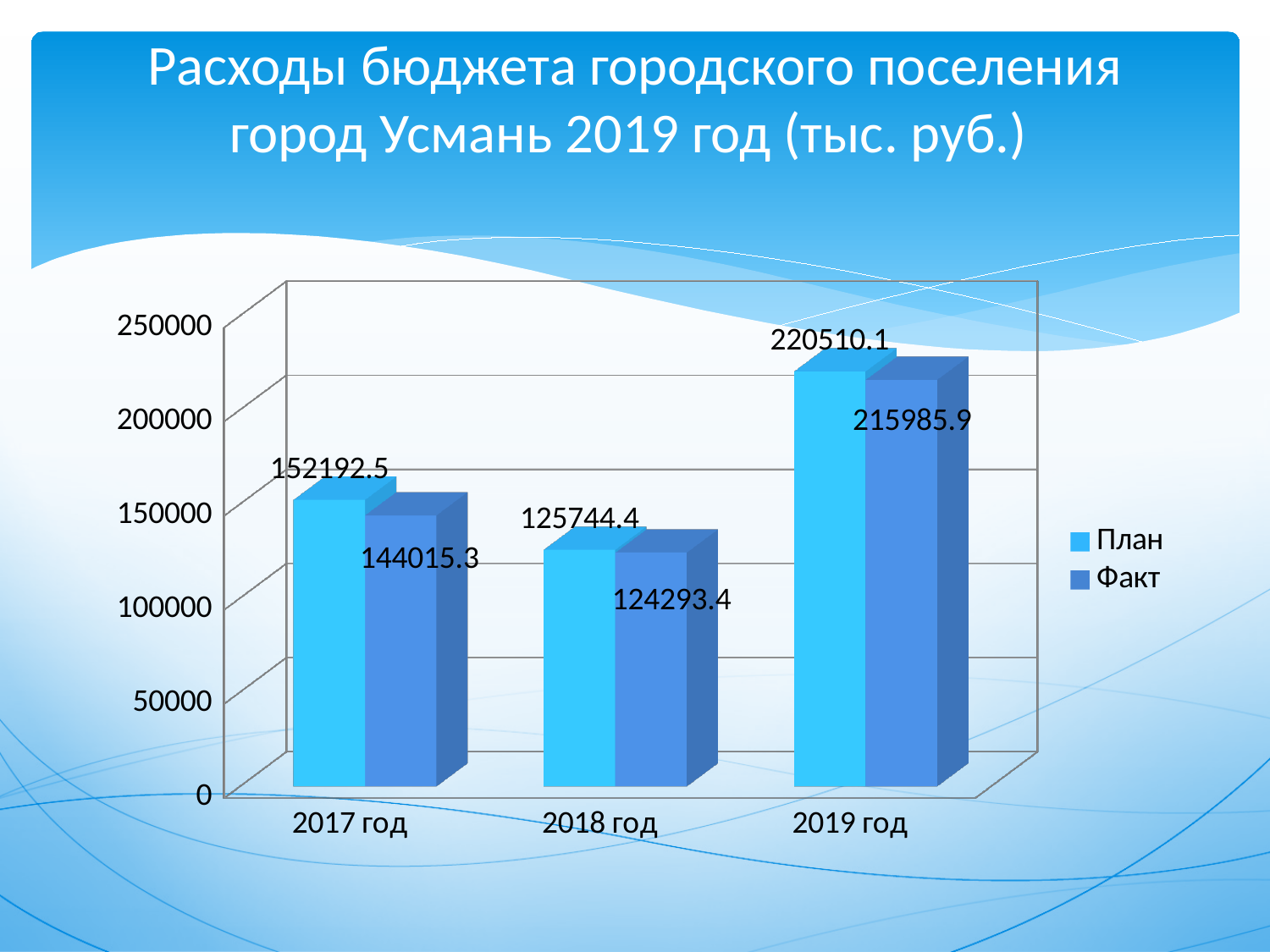
How many series does the legend list? 2 Which year has the lowest Факт value? 2018 год What is the Факт value for 2019 год? 215985.9 Which year has the highest План value? 2019 год What is the difference between the План values for 2019 год and 2017 год? 68317.6 What is the Факт value for 2018 год? 124293.4 Is the Факт value for 2018 год greater or less than 150000? less What is the difference between План and Факт for 2017 год? 8177.2 What is the План value for 2017 год? 152192.5 What kind of chart is shown on the slide? bar chart Which is larger for 2019 год, План or Факт? План How many years are shown on the x axis? 3